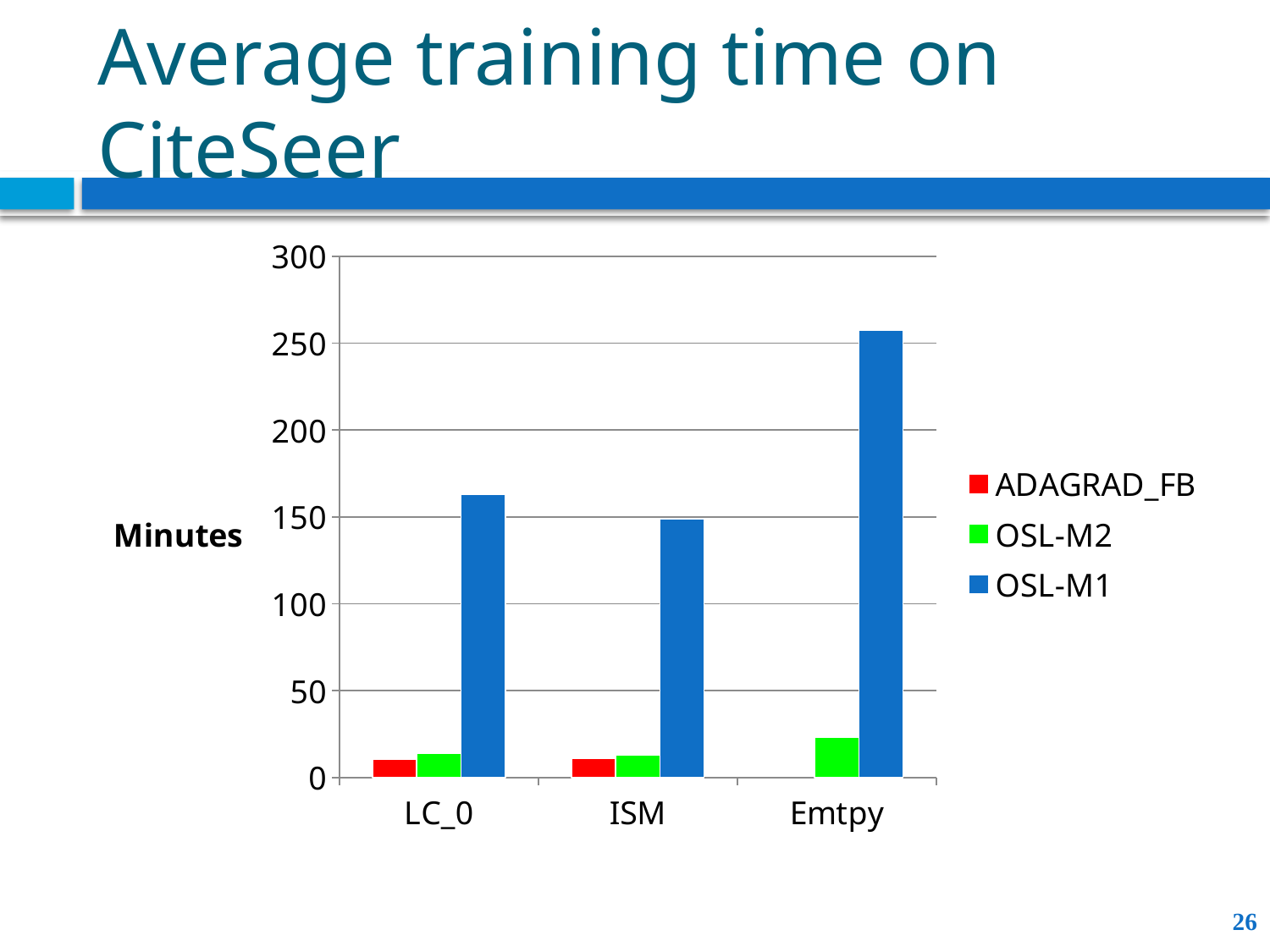
Is the OSL-M2 value for Emtpy greater or less than 50? less Is the OSL-M1 value for ISM greater or less than 200? less Is the OSL-M1 value for LC_0 greater or less than 150? greater What is the label on the vertical axis? Minutes How many categories are shown on the x axis? 3 For which category is the OSL-M1 bar highest? Emtpy For which category is the OSL-M1 bar lowest? ISM For which category is the OSL-M2 bar highest? Emtpy How many series does the legend list? 3 Which is larger for ISM: the OSL-M1 value or the OSL-M2 value? OSL-M1 What kind of chart is shown on the slide? bar chart